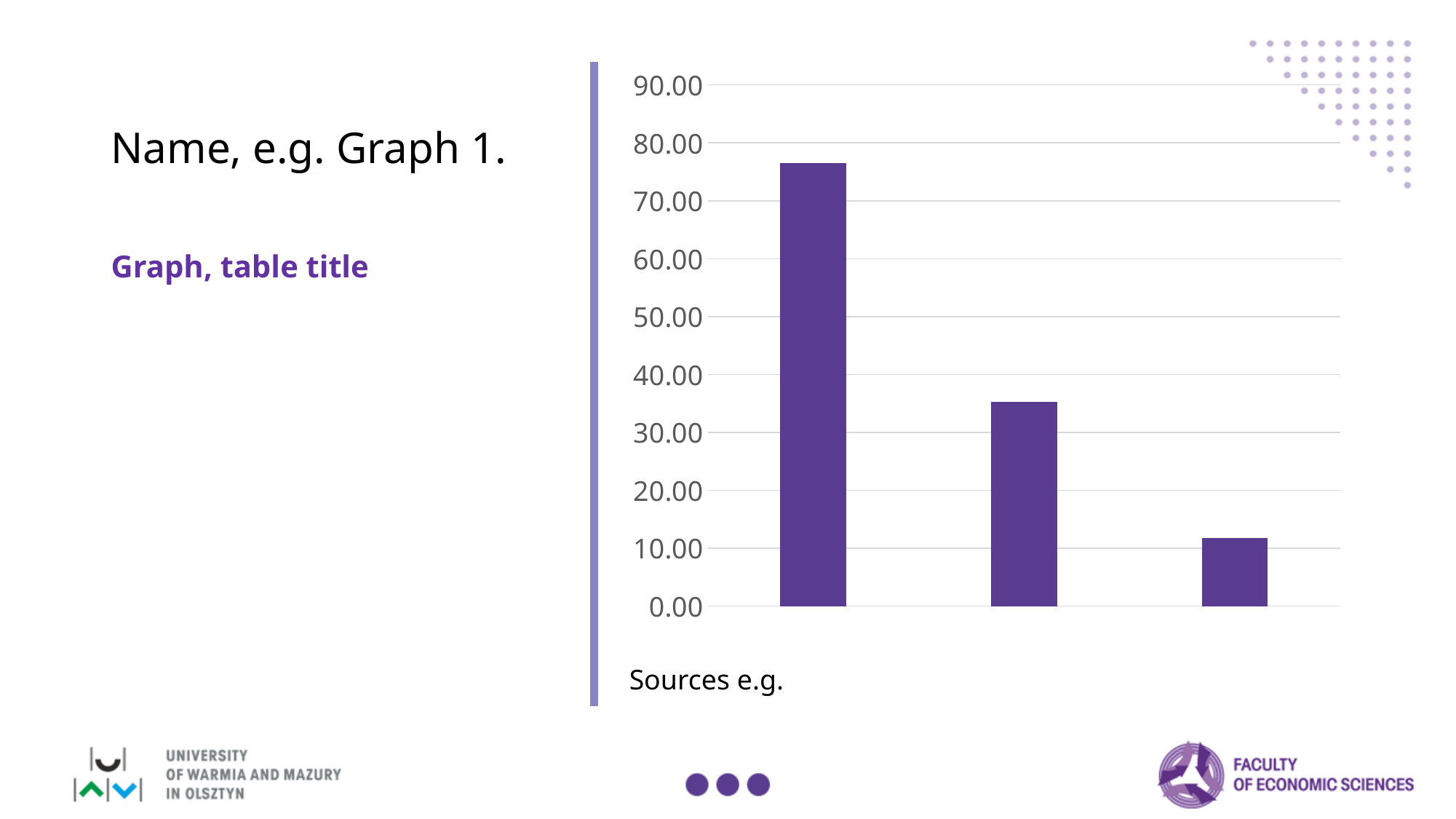
Which bar is the tallest: the leftmost, middle, or rightmost? leftmost What is the highest value shown on the vertical axis of the chart? 90.00 Which is larger, the value of the middle bar or the value of the rightmost bar? middle bar Is the value of the leftmost bar greater or less than 70.00? greater What kind of chart is shown on the slide? bar chart Do the bar values rise or fall from left to right across the chart? fall Is the value of the middle bar greater or less than 40.00? less Is the value of the leftmost bar greater or less than 80.00? less Which bar is the shortest: the leftmost, middle, or rightmost? rightmost How many bars are plotted in the chart? 3